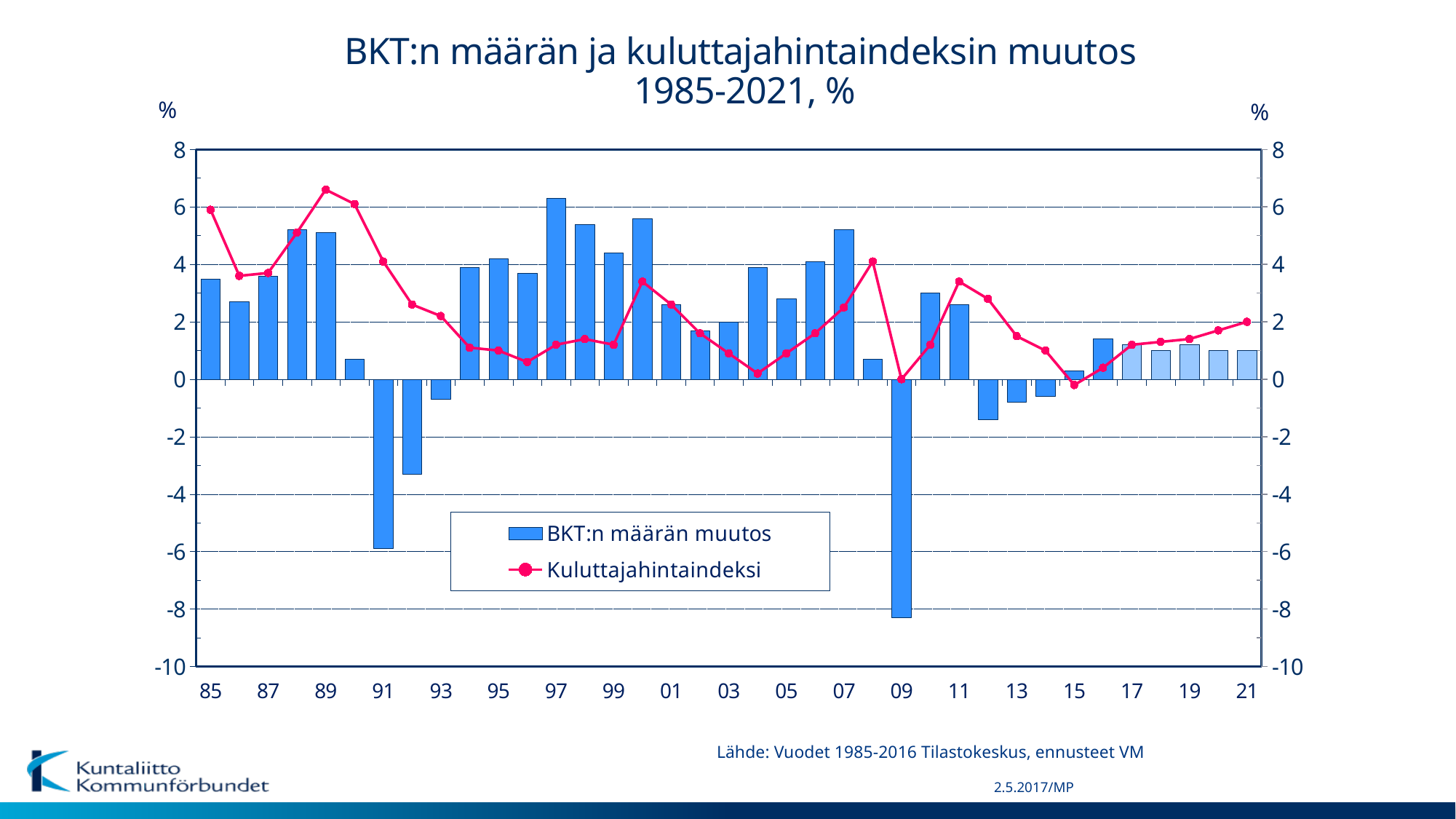
How many series does the legend list? 2 Is the Kuluttajahintaindeksi value for 1985 greater or less than 4? greater Which series is drawn as a line with markers? Kuluttajahintaindeksi What kind of chart is shown on the slide? A combined bar and line chart Which series is drawn as bars? BKT:n määrän muutos In which year does the Kuluttajahintaindeksi line reach its highest value? 1989 In which year is the BKT:n määrän muutos bar highest? 1997 How many years are plotted on the x axis? 37 Is the BKT:n määrän muutos value for 1991 greater or less than -4? less Is the BKT:n määrän muutos value for 2009 greater or less than -6? less Which year has the lower BKT:n määrän muutos bar, 1991 or 2009? 2009 In which year is the BKT:n määrän muutos bar lowest? 2009